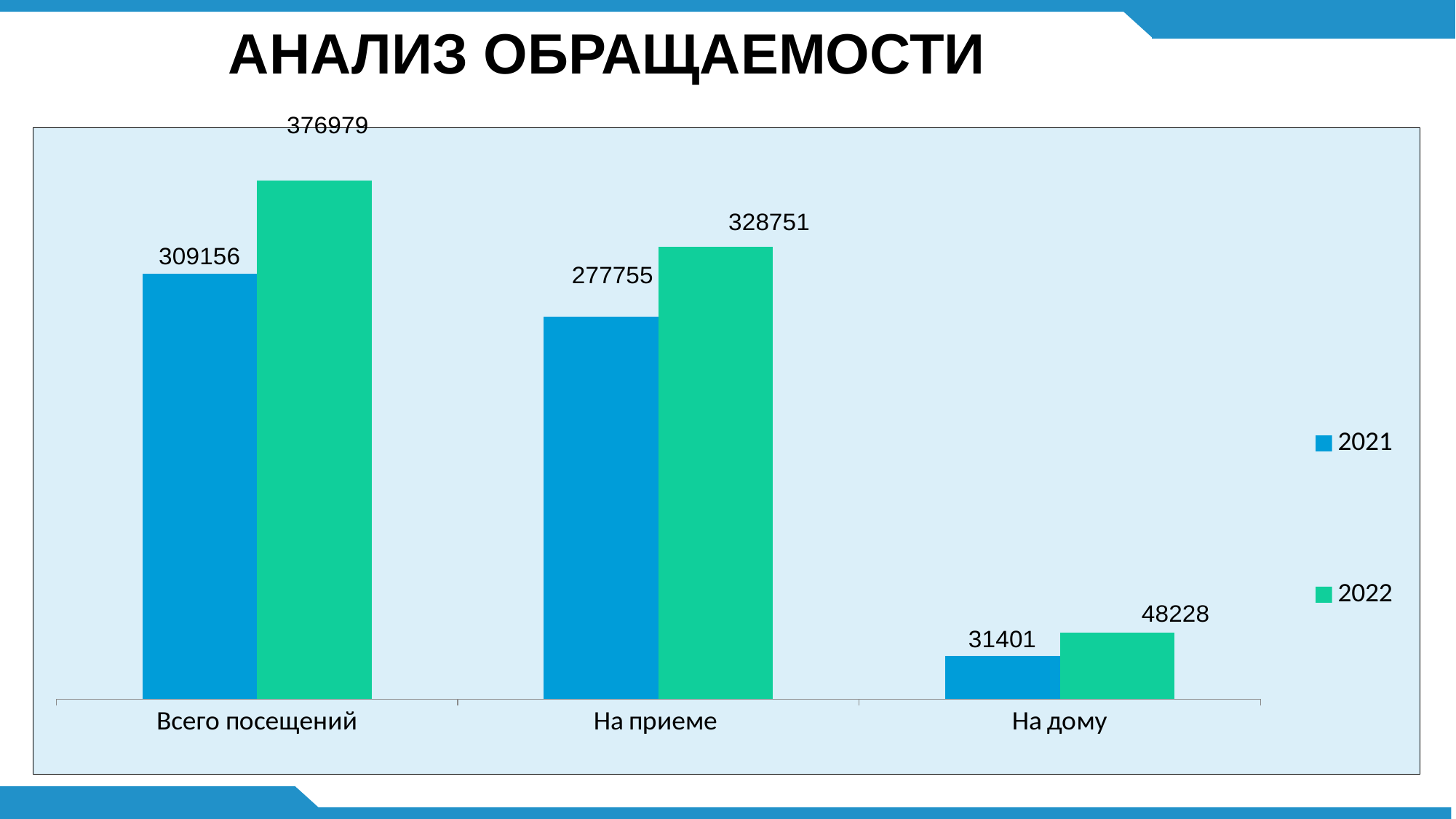
Which category has the highest value for the 2022 series? Всего посещений How many series does the legend list? 2 Which category has the lowest value for the 2021 series? На дому What is the value for 2022 in the "На дому" category? 48228 What is the value for 2022 in the "Всего посещений" category? 376979 What is the difference between the 2022 and 2021 values for "На дому"? 16827 What is the difference between the 2022 and 2021 values for "Всего посещений"? 67823 What is the value for 2021 in the "На приеме" category? 277755 How many categories are shown on the x axis? 3 What kind of chart is shown on the slide? Bar chart What is the value for 2021 in the "На дому" category? 31401 Which is larger for "На приеме": the 2021 value or the 2022 value? 2022